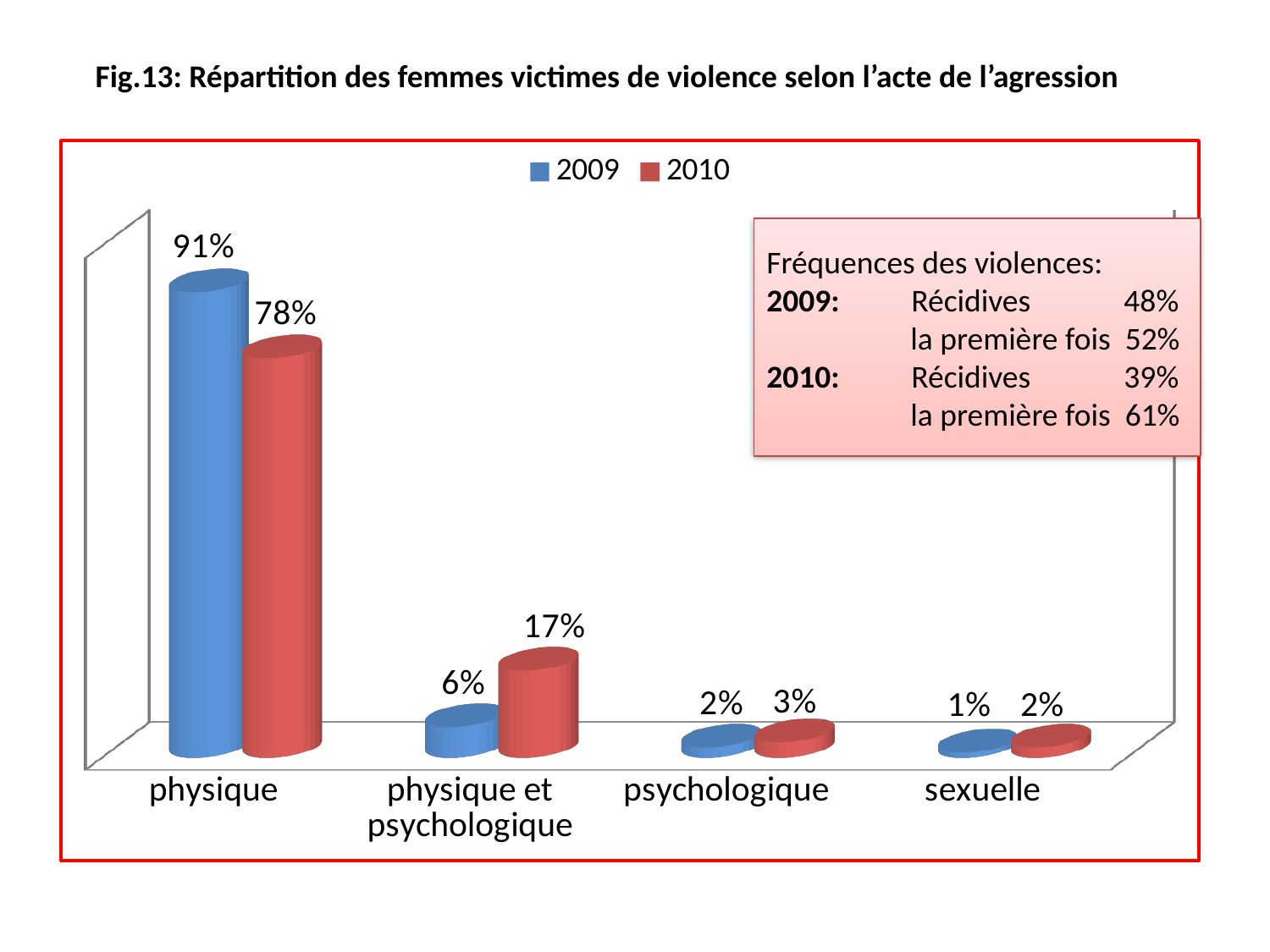
How many categories are shown on the x axis? 4 What is the value for 'sexuelle' in the 2009 series? 1% What is the value for 'physique et psychologique' in the 2010 series? 17% What is the difference between the 2009 and 2010 values for 'physique'? 13% Which category has the highest value in the 2009 series? physique What is the difference between the 2010 and 2009 values for 'physique et psychologique'? 11% What kind of chart is shown on the slide? bar chart How many series does the legend list? 2 What is the value for 'physique' in the 2009 series? 91% Which category has the lowest value in the 2010 series? sexuelle Which is larger for 'psychologique': the 2009 value or the 2010 value? 2010 What is the value for 'physique' in the 2010 series? 78%